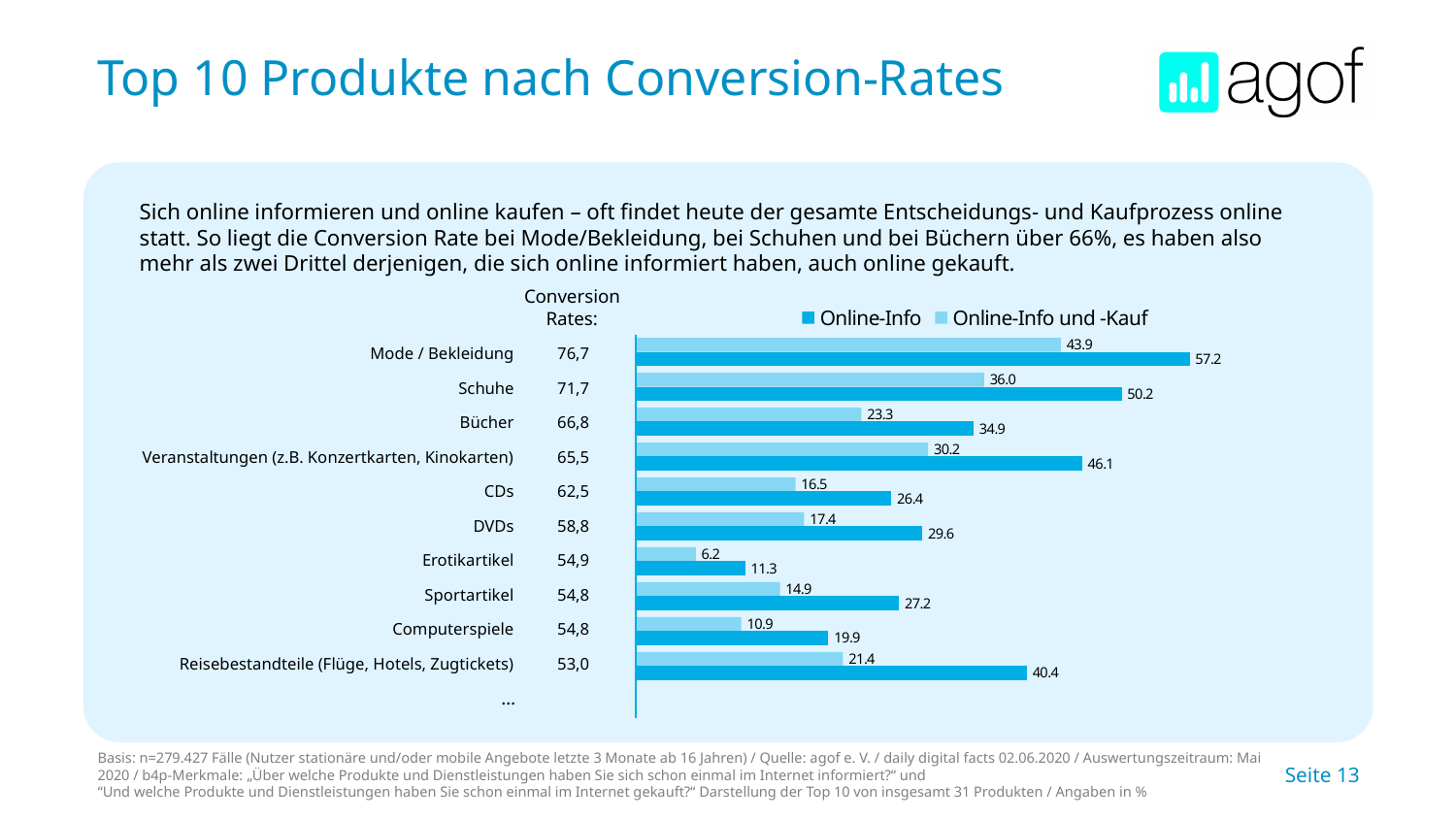
What is the Online-Info value for Mode / Bekleidung? 57.2 What is the Online-Info und -Kauf value for Schuhe? 36.0 Which has the larger Online-Info value, Bücher or Reisebestandteile (Flüge, Hotels, Zugtickets)? Reisebestandteile (Flüge, Hotels, Zugtickets) What is the difference between the Online-Info and Online-Info und -Kauf values for Mode / Bekleidung? 13.3 How many product categories are shown in the chart? 10 What is the difference between the Online-Info and Online-Info und -Kauf values for Schuhe? 14.2 What is the Online-Info und -Kauf value for Reisebestandteile (Flüge, Hotels, Zugtickets)? 21.4 How many series does the legend list? 2 What kind of chart is shown on the slide? Bar chart What is the Online-Info value for CDs? 26.4 Which category has the highest Online-Info value? Mode / Bekleidung Which category has the lowest Online-Info und -Kauf value? Erotikartikel